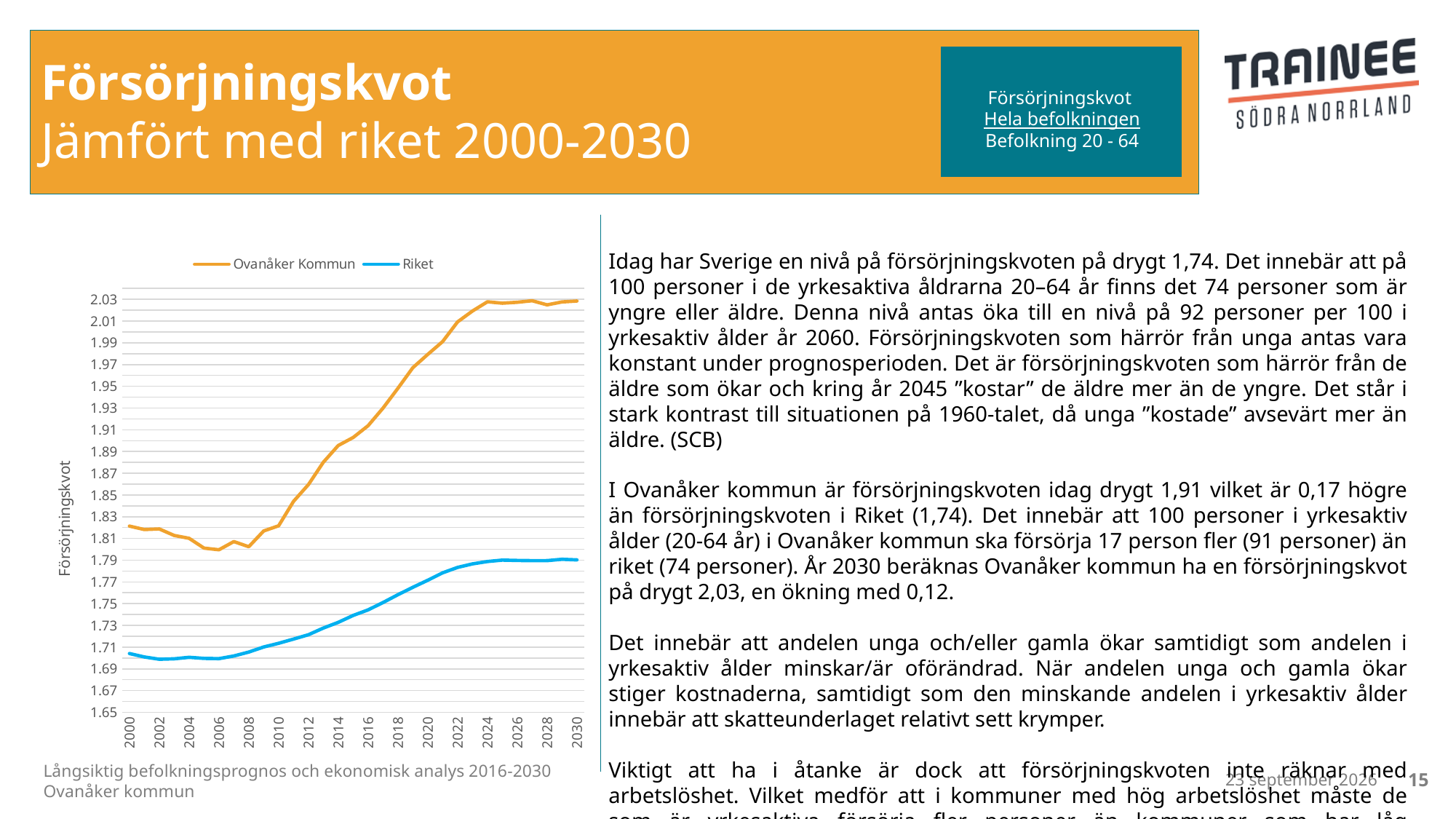
What is the label on the chart's vertical axis? Försörjningskvot Which series has the higher value in 2030, Ovanåker Kommun or Riket? Ovanåker Kommun Which series is lower across the whole period 2000-2030? Riket How many series does the chart's legend list? 2 Is the value for Riket in 2000 greater or less than 1.75? less Is the value for Ovanåker Kommun in 2030 greater or less than 1.99? greater Does the Riket line rise or fall overall from 2000 to 2030? rise How many year labels are shown on the chart's x axis? 16 Is the value for Riket in 2030 greater or less than 1.75? greater What are the two series named in the chart's legend? Ovanåker Kommun and Riket What kind of chart is shown on the slide? line chart